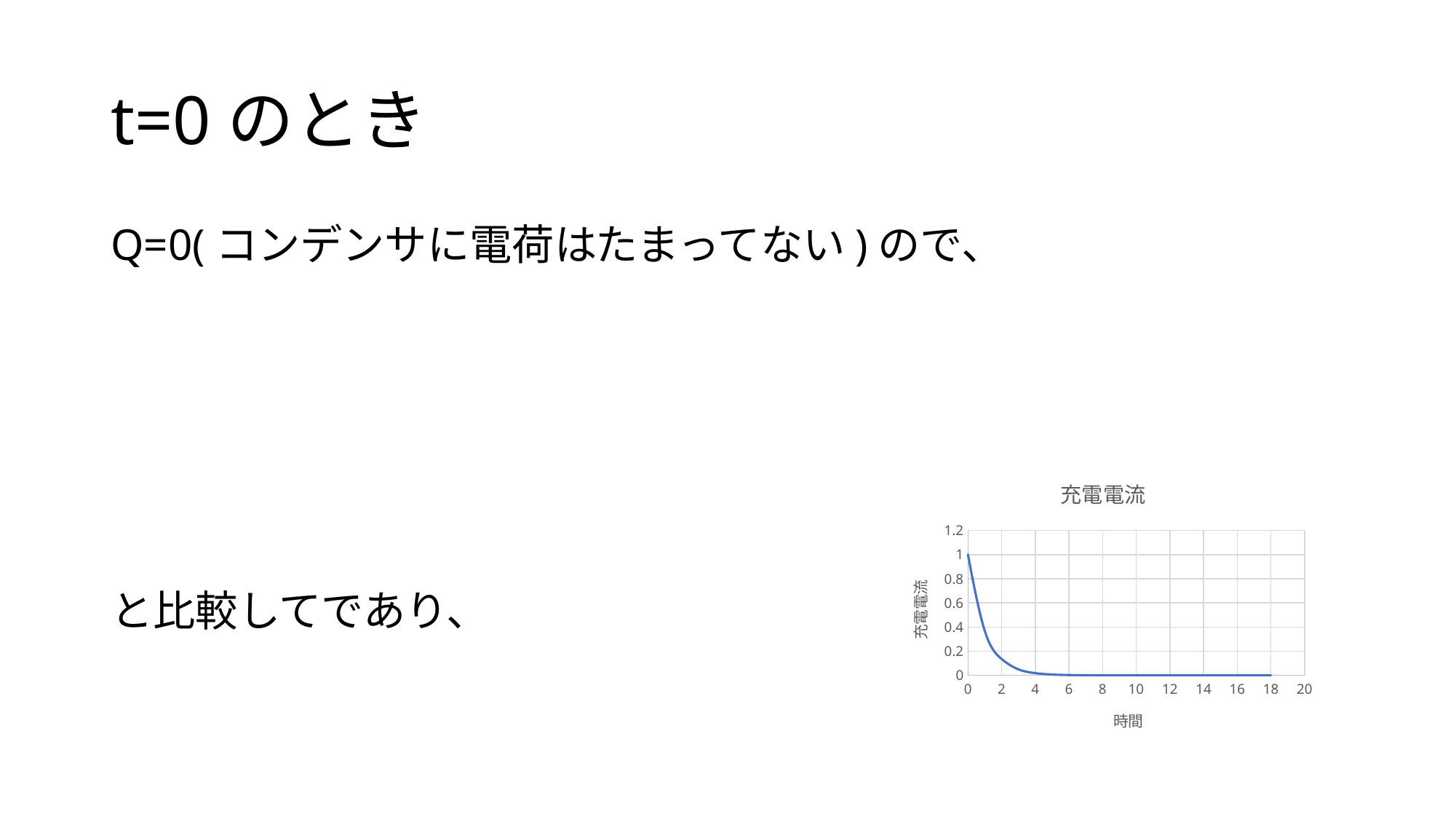
What is the highest tick value shown on the x axis? 20 What is the highest tick value shown on the y axis? 1.2 What is the label of the x axis of the chart? 時間 Is the charging current at time 2 greater or less than 0.6? less Which is larger, the charging current at time 1 or at time 4? time 1 What kind of chart is shown on the slide? line chart At which time value is the charging current highest? 0 What is the title of the chart? 充電電流 Is the charging current at time 0 greater or less than 0.8? greater Is the charging current at time 10 greater or less than 0.2? less Does the charging current rise or fall as time increases along the x axis? fall